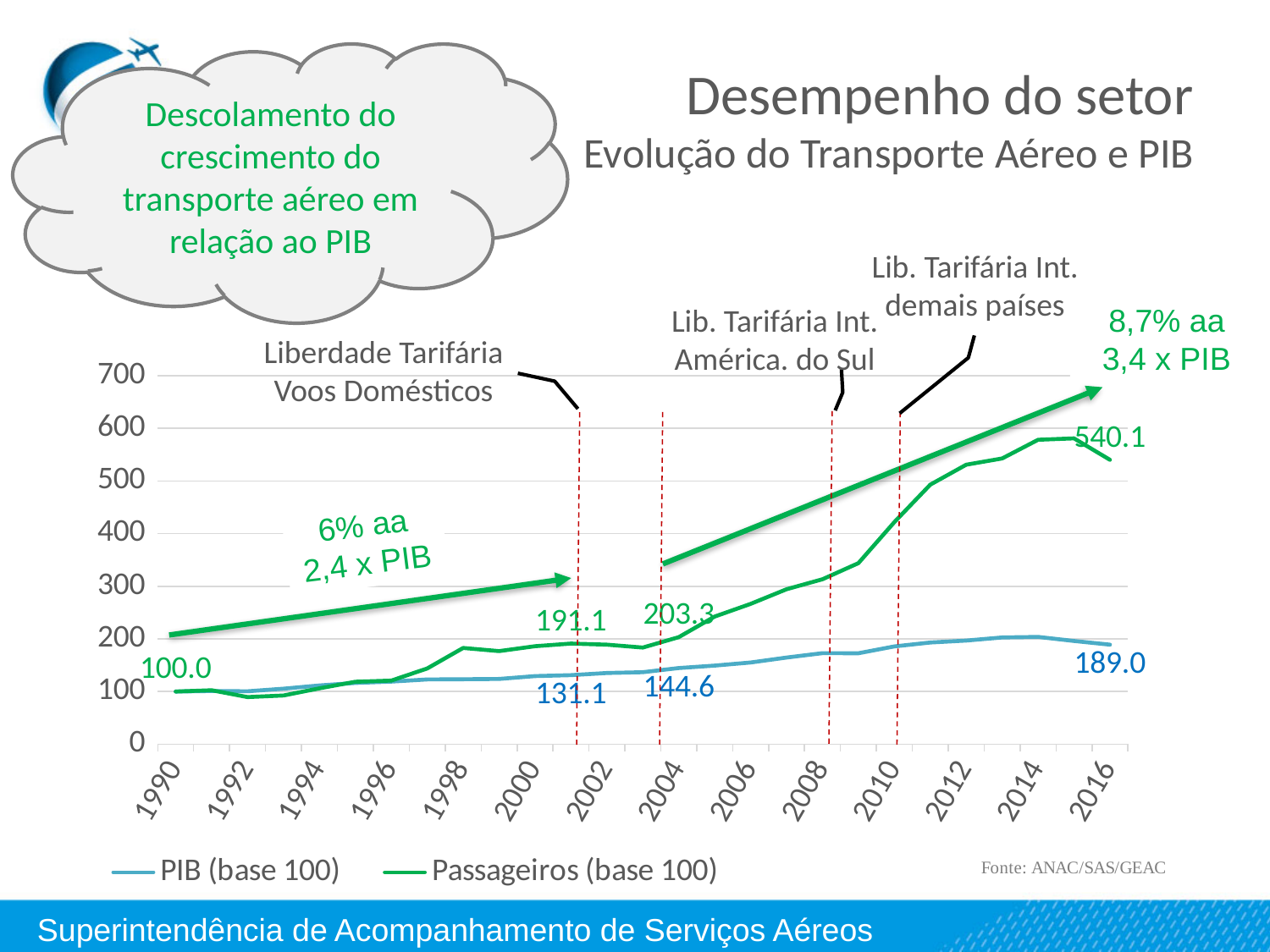
What are the two series named in the legend? PIB (base 100) and Passageiros (base 100) In 2016, which series has the larger value, PIB (base 100) or Passageiros (base 100)? Passageiros (base 100) What is the value of Passageiros (base 100) in 2016? 540.1 Does the PIB (base 100) line rise or fall overall from 1990 to 2016? rises Is the value for PIB (base 100) in 2008 greater or less than 200? less What kind of chart is shown on the slide? line chart Is the value for Passageiros (base 100) in 2010 greater or less than 300? greater What is the difference between the Passageiros value and the PIB value in 2016? 351.1 What is the value of PIB (base 100) in 2016? 189.0 What is the subtitle of the chart below 'Desempenho do setor'? Evolução do Transporte Aéreo e PIB What value do both series start at in 1990? 100.0 How many series does the chart legend list? 2